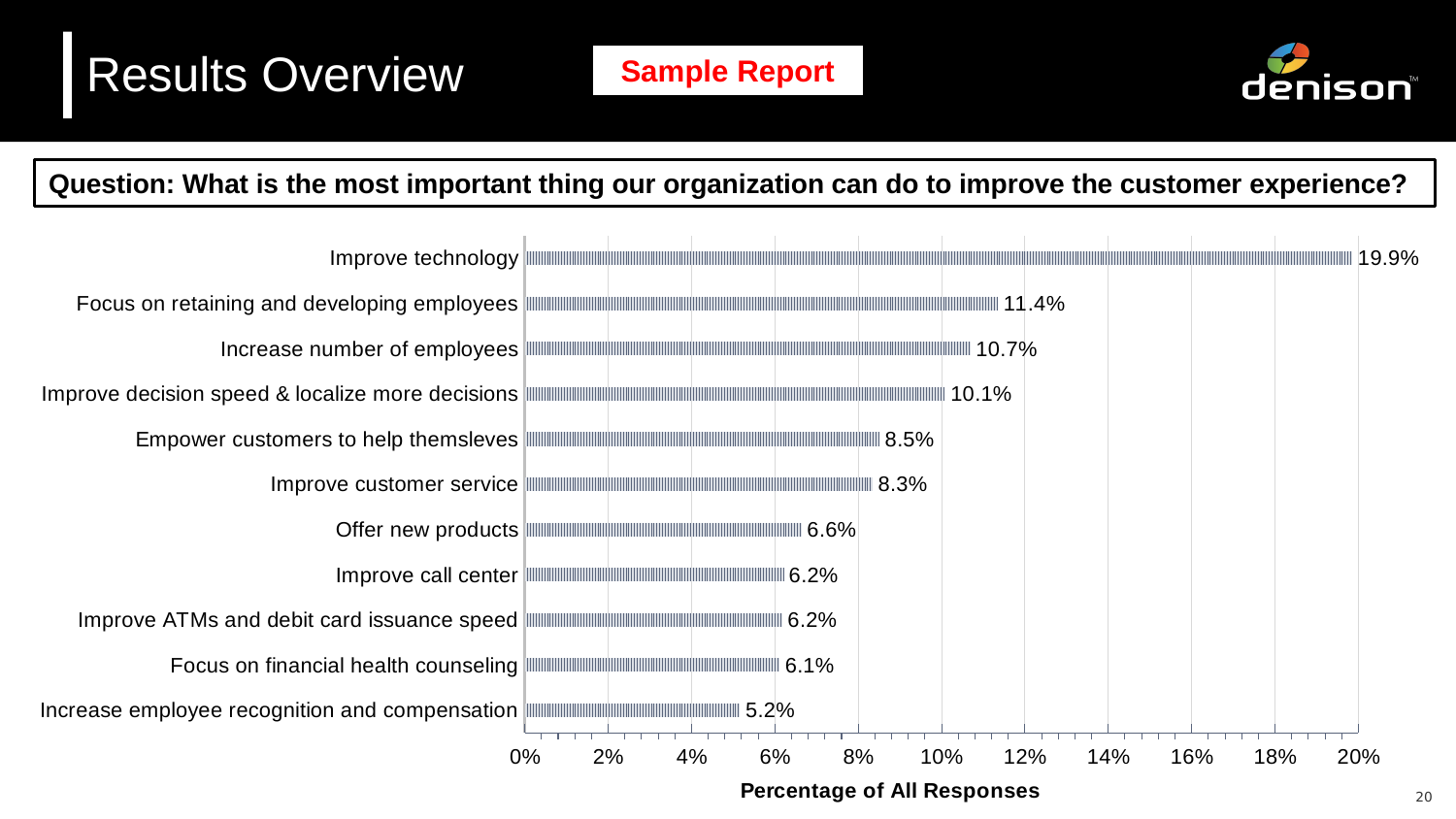
Which is larger: the value for "Increase number of employees" or the value for "Improve decision speed & localize more decisions"? Increase number of employees Which category has the lowest percentage of all responses? Increase employee recognition and compensation What is the value for "Focus on retaining and developing employees"? 11.4% What is the difference between the values for "Improve technology" and "Focus on retaining and developing employees"? 8.5% What percentage of responses is shown for "Improve technology"? 19.9% How many categories are plotted in the chart? 11 Is the value for "Offer new products" greater or less than 8%? less What percentage is shown for "Improve customer service"? 8.3% What kind of chart is shown on the slide? Bar chart What is the value for "Focus on financial health counseling"? 6.1% What is the label of the horizontal axis? Percentage of All Responses Which category has the highest percentage of all responses? Improve technology